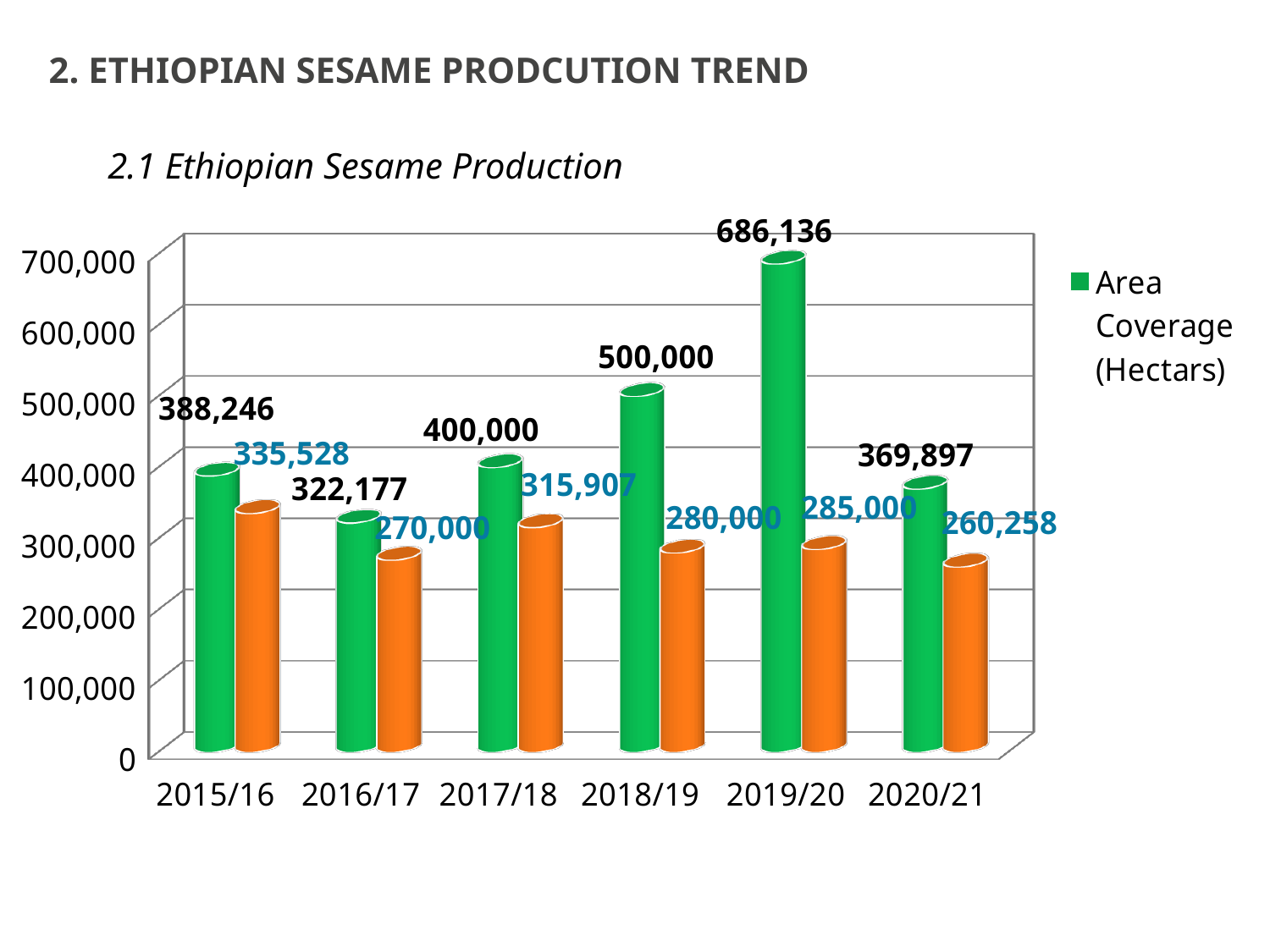
Which year has the lowest Area Coverage (Hectars)? 2016/17 Which year has the highest Area Coverage (Hectars)? 2019/20 What kind of chart is shown on the slide? Bar chart Which is larger, the Area Coverage (Hectars) for 2017/18 or for 2020/21? 2017/18 What value is labelled on the orange bar for 2020/21? 260,258 How many series does the legend list? 1 What is the Area Coverage (Hectars) value for 2016/17? 322,177 How many years are shown on the x axis? 6 What is the difference between the Area Coverage (Hectars) values for 2019/20 and 2018/19? 186,136 What is the Area Coverage (Hectars) value for 2019/20? 686,136 What is the title of the chart? 2.1 Ethiopian Sesame Production What value is labelled on the orange bar for 2015/16? 335,528